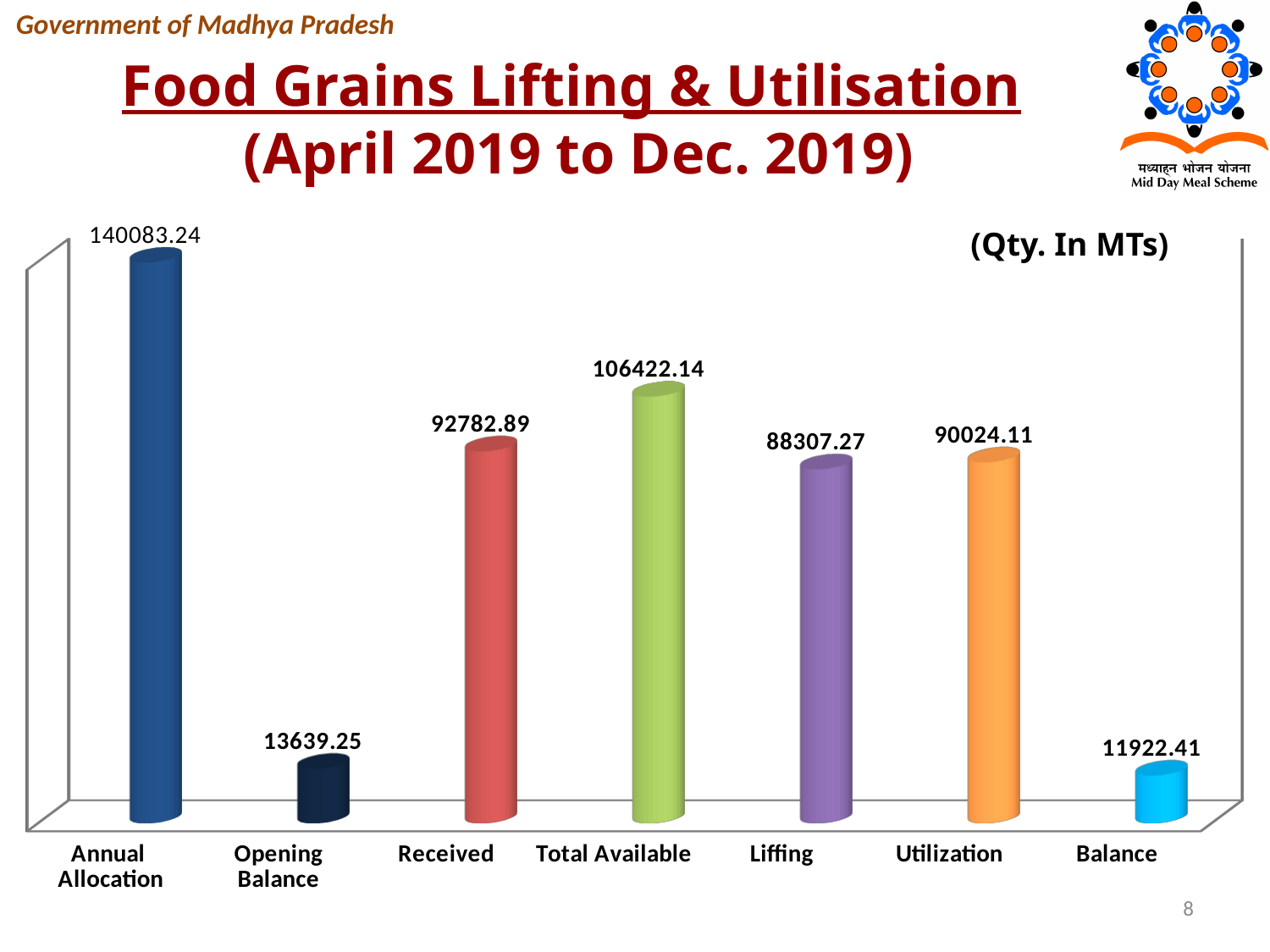
What kind of chart is shown on the slide? Bar chart What is the value for Annual Allocation? 140083.24 In what unit are the quantities in the chart expressed? MTs What is the value for Balance? 11922.41 What is the difference between Opening Balance and Balance? 1716.84 Which category has the highest value? Annual Allocation What is the difference between Total Available and Lifting? 18114.87 What is the value for Utilization? 90024.11 Which category has the lowest value? Balance What is the value for Total Available? 106422.14 Which is larger, Received or Total Available? Total Available How many categories are shown in the chart? 7